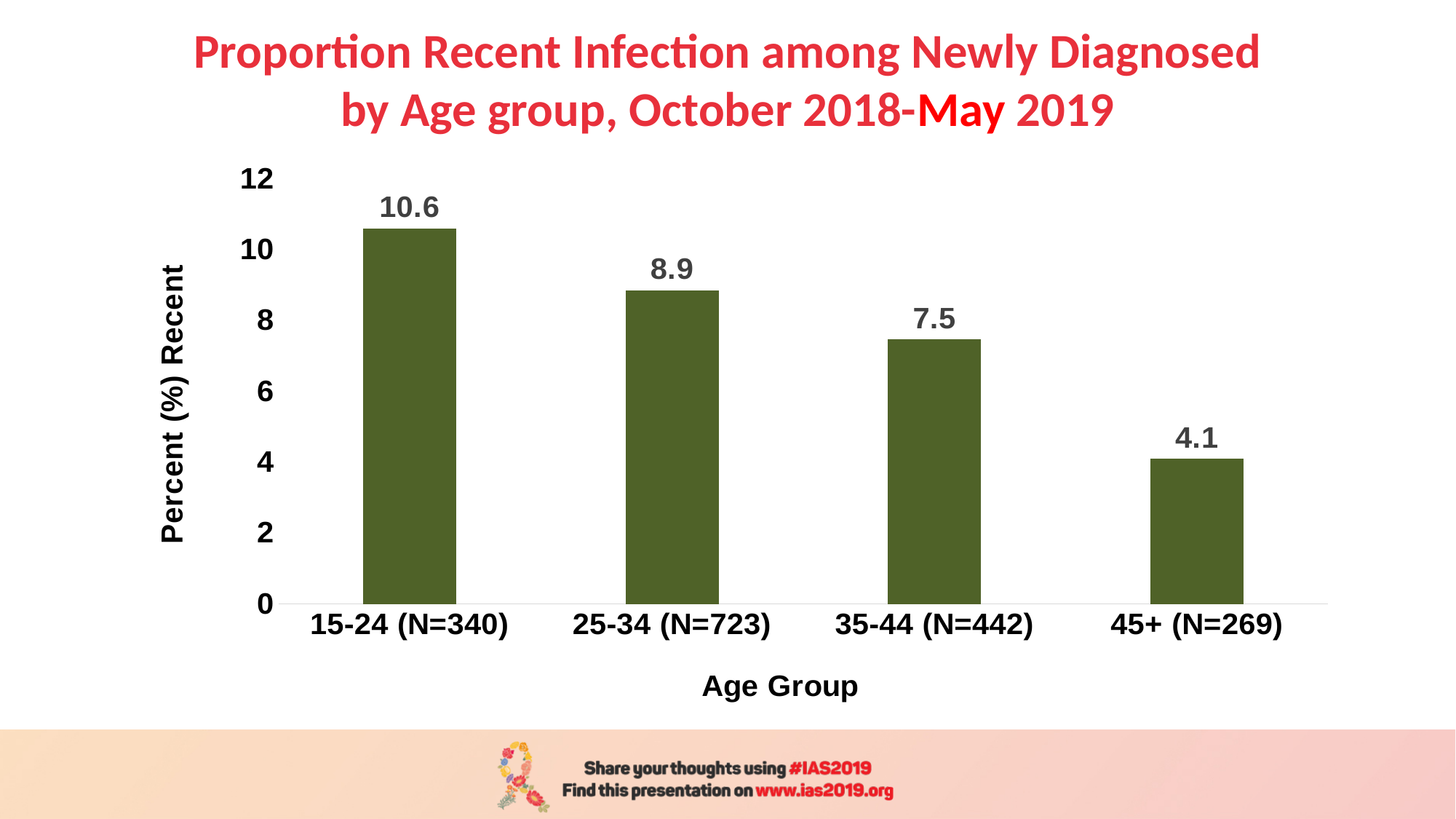
Do the values rise or fall as age group increases along the x axis? Fall Which has a higher percent recent, the 25-34 age group or the 35-44 age group? 25-34 (N=723) Which age group has the lowest percent recent? 45+ (N=269) Which age group has the highest percent recent? 15-24 (N=340) What is the difference in percent recent between the 25-34 and 35-44 age groups? 1.4 What is the difference in percent recent between the 15-24 and 45+ age groups? 6.5 How many age groups are shown in the chart? 4 What kind of chart is shown on the slide? Bar chart What is the percent recent for the 15-24 (N=340) age group? 10.6 What is the percent recent for the 25-34 (N=723) age group? 8.9 What is the percent recent for the 45+ (N=269) age group? 4.1 What is the percent recent for the 35-44 (N=442) age group? 7.5